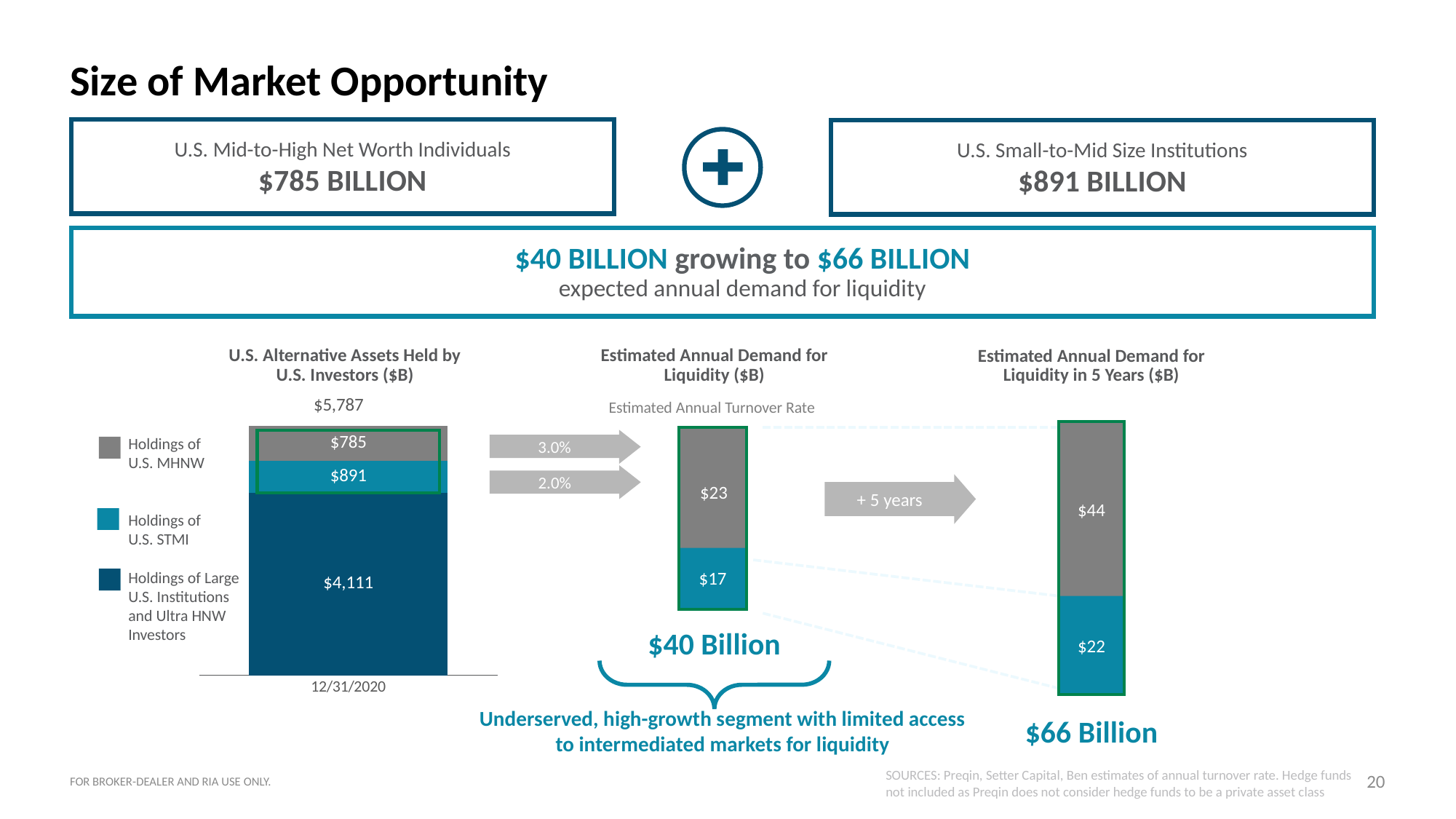
In the "U.S. Alternative Assets Held by U.S. Investors ($B)" chart, what is the value for Holdings of U.S. MHNW? $785 In the "Estimated Annual Demand for Liquidity in 5 Years ($B)" chart, what is the total of the stacked bar? $66 Billion In the "Estimated Annual Demand for Liquidity in 5 Years ($B)" chart, what is the value of the teal (bottom) segment? $22 In the "U.S. Alternative Assets Held by U.S. Investors ($B)" chart, which holdings segment is the largest? Holdings of Large U.S. Institutions and Ultra HNW Investors In the "U.S. Alternative Assets Held by U.S. Investors ($B)" chart, how many series does the legend list? 3 In the "U.S. Alternative Assets Held by U.S. Investors ($B)" chart, what is the total of the stacked bar? $5,787 In the "Estimated Annual Demand for Liquidity ($B)" chart, what is the value of the grey (top) segment? $23 In the "U.S. Alternative Assets Held by U.S. Investors ($B)" chart, what is the value for Holdings of U.S. STMI? $891 In the "U.S. Alternative Assets Held by U.S. Investors ($B)" chart, what date is shown on the x axis? 12/31/2020 What kind of chart is the "U.S. Alternative Assets Held by U.S. Investors ($B)" chart? Stacked bar chart In the "Estimated Annual Demand for Liquidity ($B)" chart, what is the difference between the grey segment and the teal segment? $6 In the "U.S. Alternative Assets Held by U.S. Investors ($B)" chart, what is the value for Holdings of Large U.S. Institutions and Ultra HNW Investors? $4,111